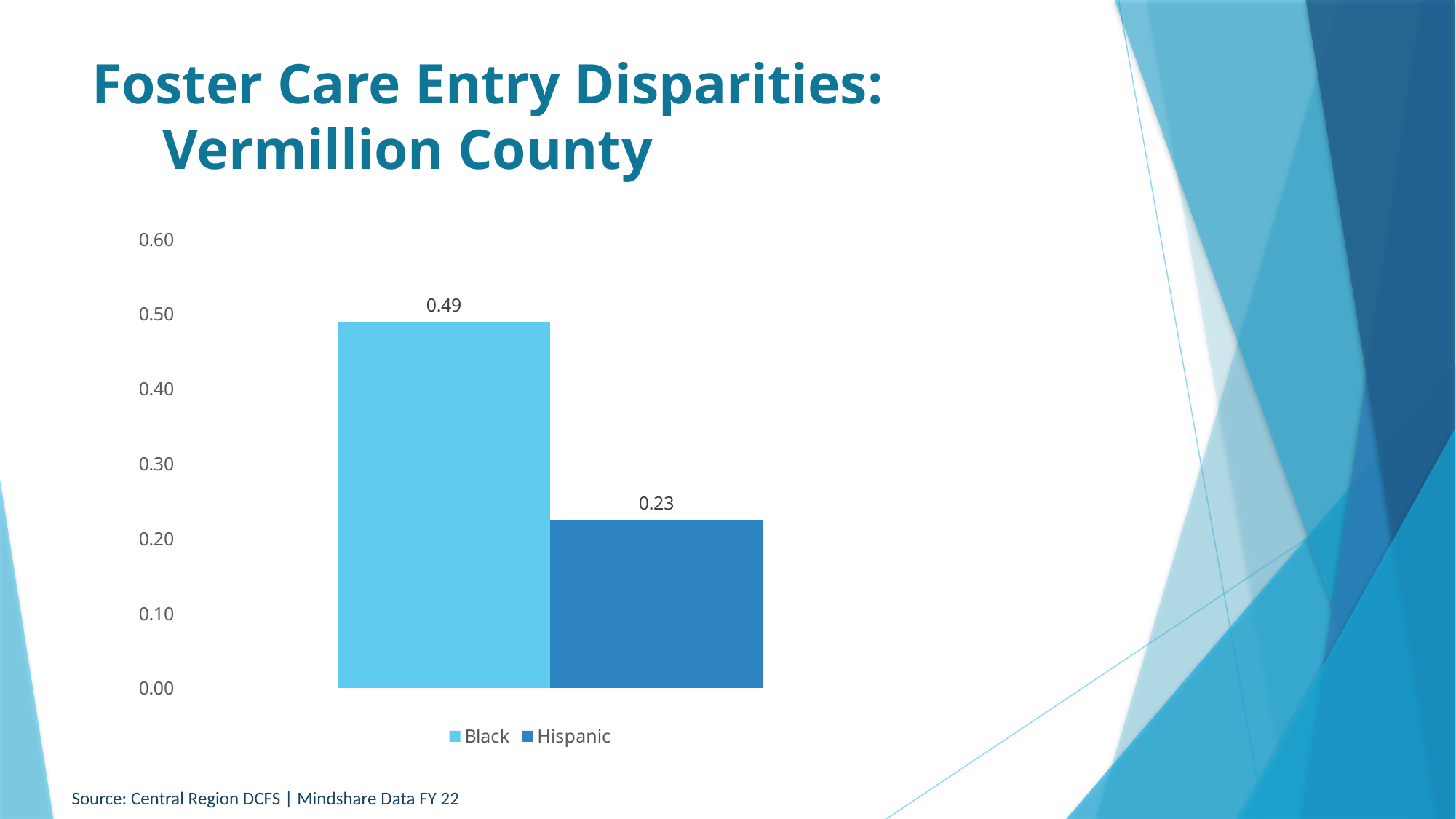
What is the source cited for the chart data? Central Region DCFS | Mindshare Data FY 22 Which is larger, the value for Black or the value for Hispanic? Black How many bars are plotted on the chart? 2 Is the value for Black greater or less than 0.40? greater How many series does the legend list? 2 Which series has the lowest value? Hispanic What kind of chart is shown on the slide? bar chart What is the difference between the values for Black and Hispanic? 0.26 What is the value for Black? 0.49 Is the value for Hispanic greater or less than 0.30? less What is the value for Hispanic? 0.23 Which series has the highest value? Black